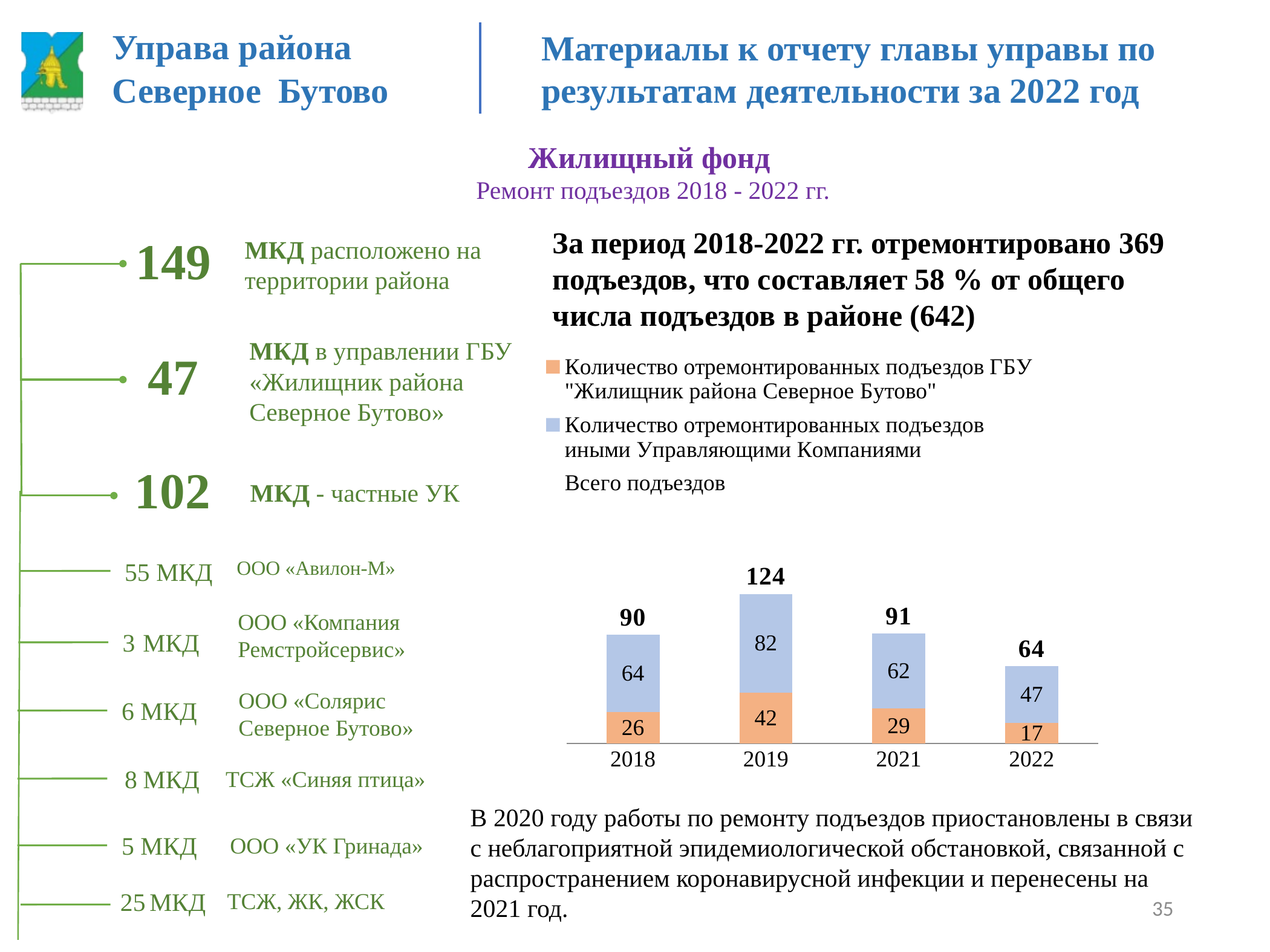
What is the sum of the two segments of the 2018 bar? 90 How many years are shown on the x axis of the chart? 4 Which is larger: the number of entrances repaired by ГБУ "Жилищник" in 2018 or in 2021? 2021 In which year was the total number of repaired entrances the highest? 2019 In which year was the total number of repaired entrances the lowest? 2022 How many entries does the chart legend list? 3 Which year is missing from the x axis between 2019 and 2021? 2020 What is the number of entrances repaired by ГБУ "Жилищник района Северное Бутово" in 2019? 42 What is the total number of repaired entrances (Всего подъездов) in 2021? 91 What type of chart is shown on the slide? stacked bar chart What is the number of entrances repaired by other management companies (иными Управляющими Компаниями) in 2022? 47 What is the difference between the total number of repaired entrances in 2019 and in 2022? 60